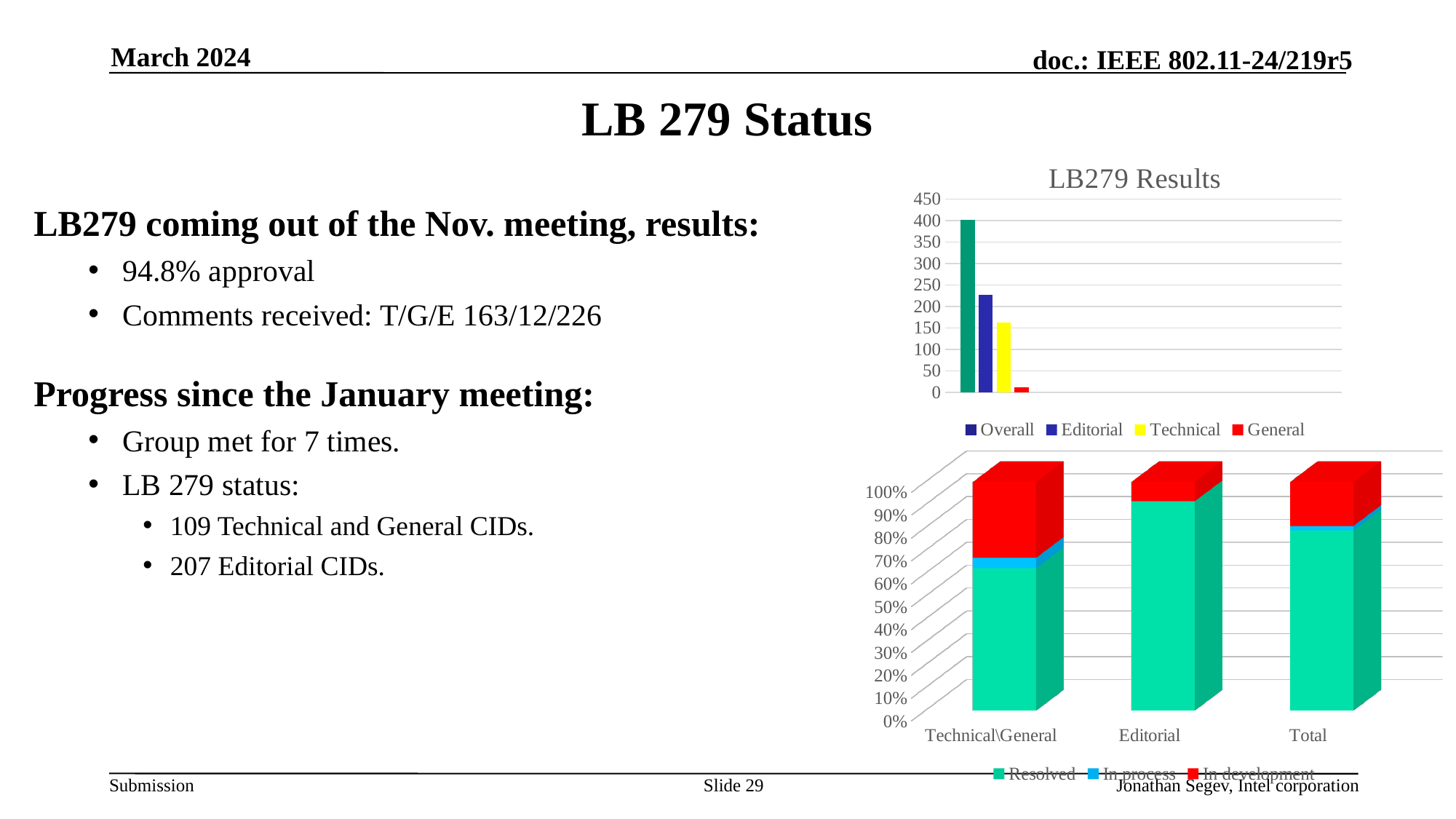
In the 'LB279 Results' chart, is the value for General greater or less than 50? less In the 'LB279 Results' chart, which series has the lowest value? General In the stacked bar chart at the bottom right, how many categories are shown on the x axis? 3 What kind of chart is the 'LB279 Results' chart at the top right? bar chart In the 'LB279 Results' chart, which is larger, Editorial or Technical? Editorial In the stacked bar chart at the bottom right, how many series does the legend list? 3 In the stacked bar chart at the bottom right, which category has the largest Resolved share? Editorial In the stacked bar chart at the bottom right, is the Resolved share for Technical\General greater or less than 50%? greater In the 'LB279 Results' chart, which series has the highest value? Overall In the 'LB279 Results' chart, is the value for Overall greater or less than 350? greater In the 'LB279 Results' chart, how many series does the legend list? 4